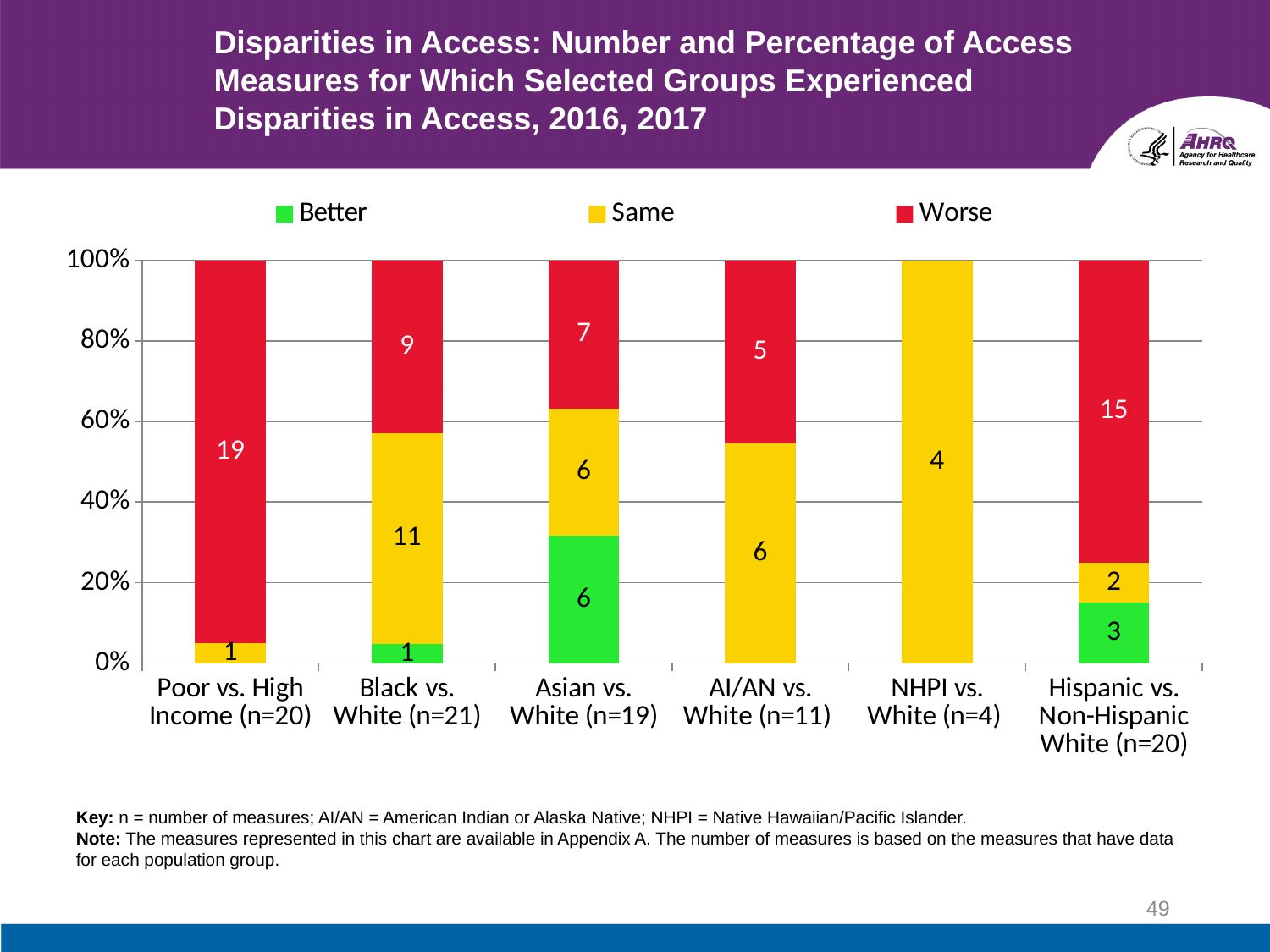
How many Better measures are shown for Hispanic vs. Non-Hispanic White (n=20)? 3 Which is larger for Asian vs. White (n=19): the Worse value or the Better value? Worse Which group has the lowest number of Same measures among those with a Same segment? Poor vs. High Income (n=20) Which group has the highest number of Worse measures? Poor vs. High Income (n=20) How many Worse measures are shown for Poor vs. High Income (n=20)? 19 How many series does the legend list? 3 What is the Same value for NHPI vs. White (n=4)? 4 How many groups are shown on the x axis? 6 What is the Same value for Black vs. White (n=21)? 11 What is the difference between the Worse values for Hispanic vs. Non-Hispanic White (n=20) and Black vs. White (n=21)? 6 What is the total of the stacked bar for Black vs. White (n=21)? 21 What kind of chart is shown on the slide? Stacked bar chart